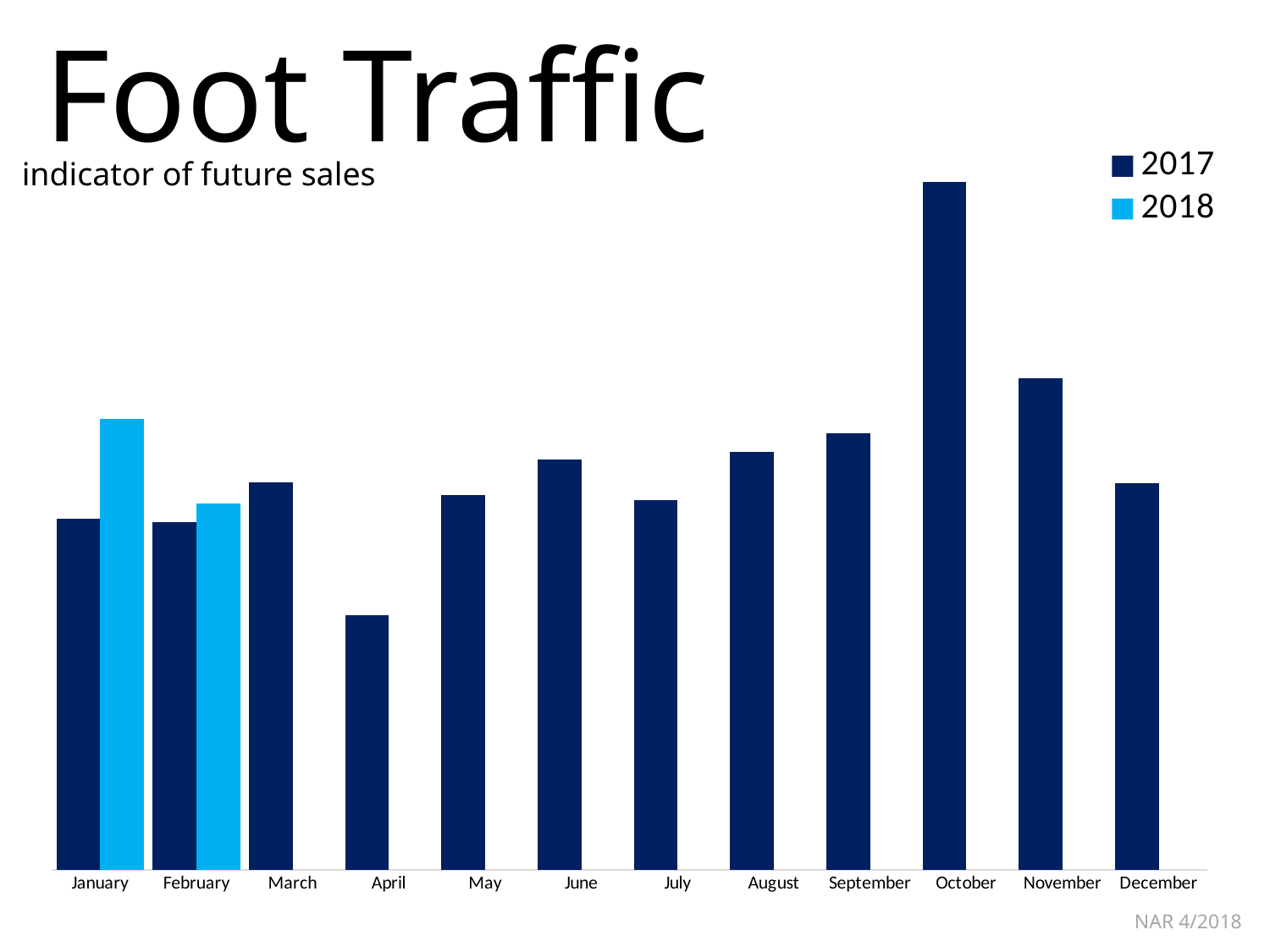
What kind of chart is shown on the slide? bar chart For February, which year has the higher foot traffic value, 2017 or 2018? 2018 Which 2017 value is larger, April or May? May Which years are listed in the legend? 2017 and 2018 Which 2017 value is larger, October or November? October How many series does the legend list? 2 Which month has the lowest 2017 foot traffic value? April What is the title of the chart? Foot Traffic How many months are shown on the x axis? 12 Do the 2017 values rise or fall from August to October? rise Which month has the highest 2017 foot traffic value? October